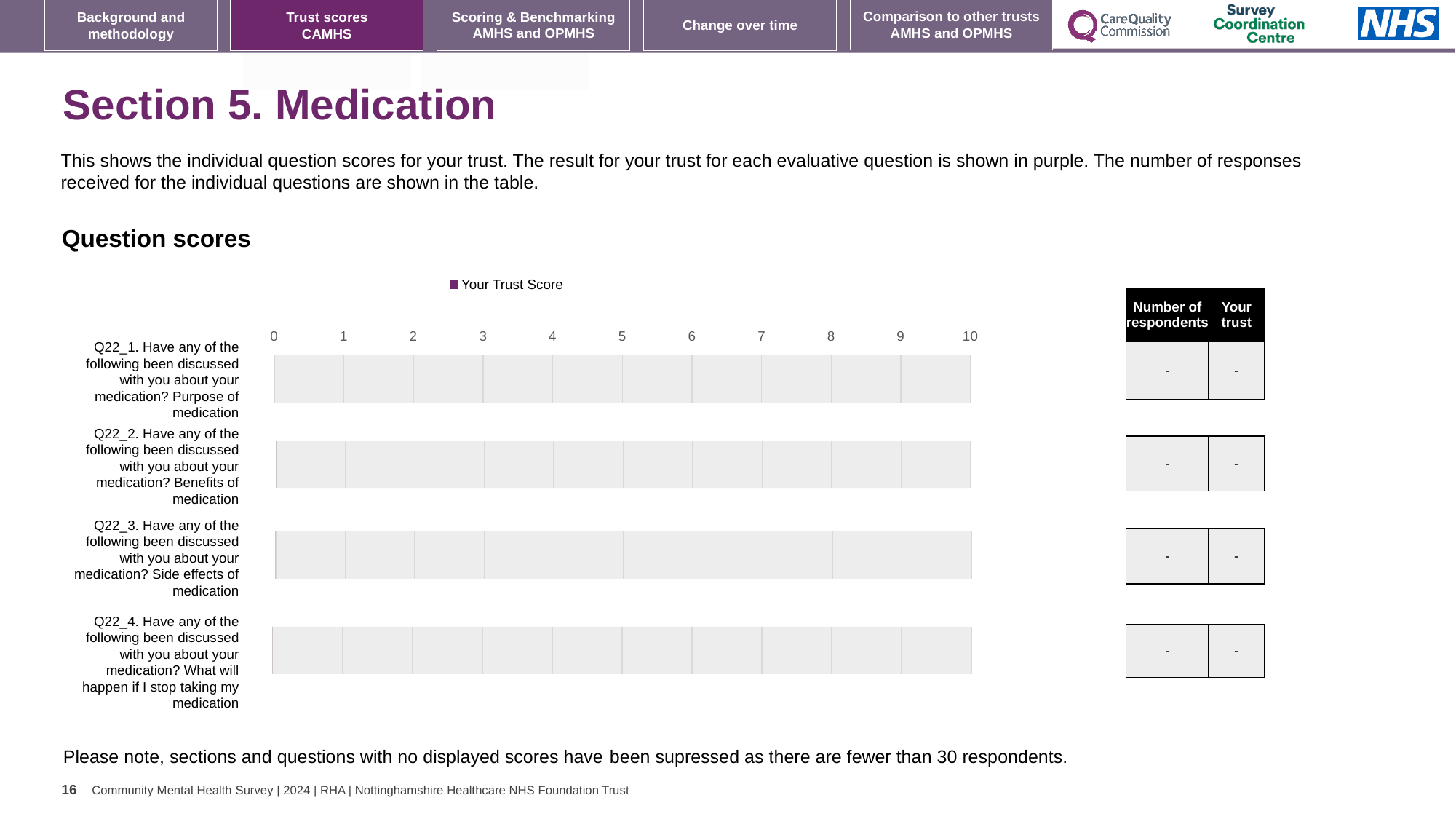
What is the 'Number of respondents' value shown in the table for Q22_2? - How many series does the chart legend list? 1 What is the 'Your trust' value shown in the table for Q22_4? - What kind of chart is shown under the 'Question scores' heading? bar chart What is the 'Number of respondents' value shown in the table for Q22_1? - What is the name of the series shown in the chart legend? Your Trust Score How many question categories are listed on the y axis of the chart? 4 What is the 'Your trust' value shown in the table for Q22_3? - What is the highest value shown on the chart's x axis? 10